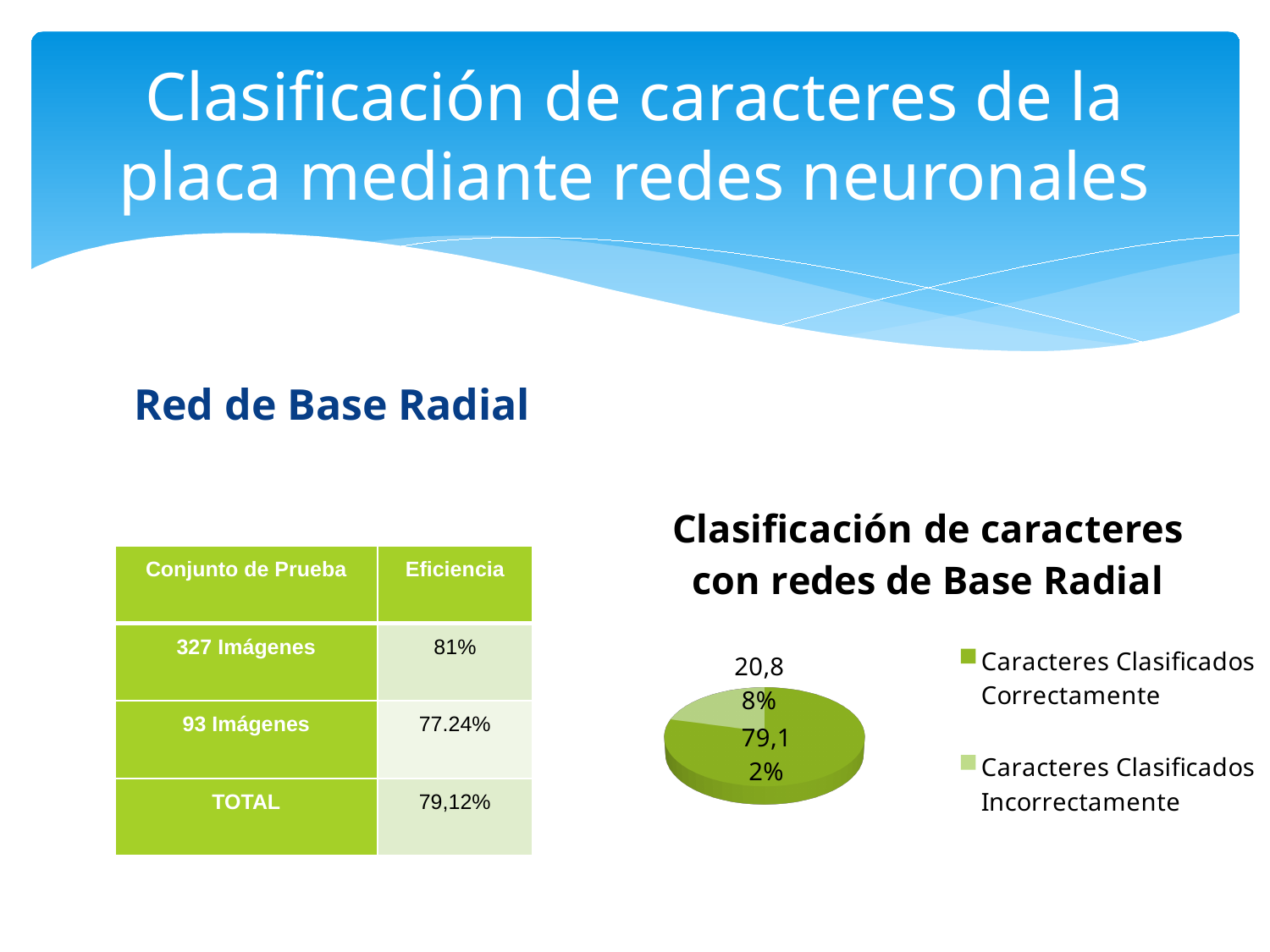
Which slice of the pie chart is the smallest? Caracteres Clasificados Incorrectamente Which legend entry is shown in the lighter green colour in the pie chart? Caracteres Clasificados Incorrectamente What percentage of the pie is labelled for Caracteres Clasificados Incorrectamente? 20,88% By how many percentage points does the Caracteres Clasificados Correctamente slice exceed the Caracteres Clasificados Incorrectamente slice? 58,24 What percentage of the pie is labelled for Caracteres Clasificados Correctamente? 79,12% Which slice of the pie chart is the largest? Caracteres Clasificados Correctamente What is the title of the pie chart? Clasificación de caracteres con redes de Base Radial What share of the pie does the Caracteres Clasificados Incorrectamente slice represent? 20,88% What kind of chart is shown on the slide? pie chart How many slices does the pie chart have? 2 Which is larger in the pie chart: Caracteres Clasificados Correctamente or Caracteres Clasificados Incorrectamente? Caracteres Clasificados Correctamente How many entries does the legend of the pie chart list? 2